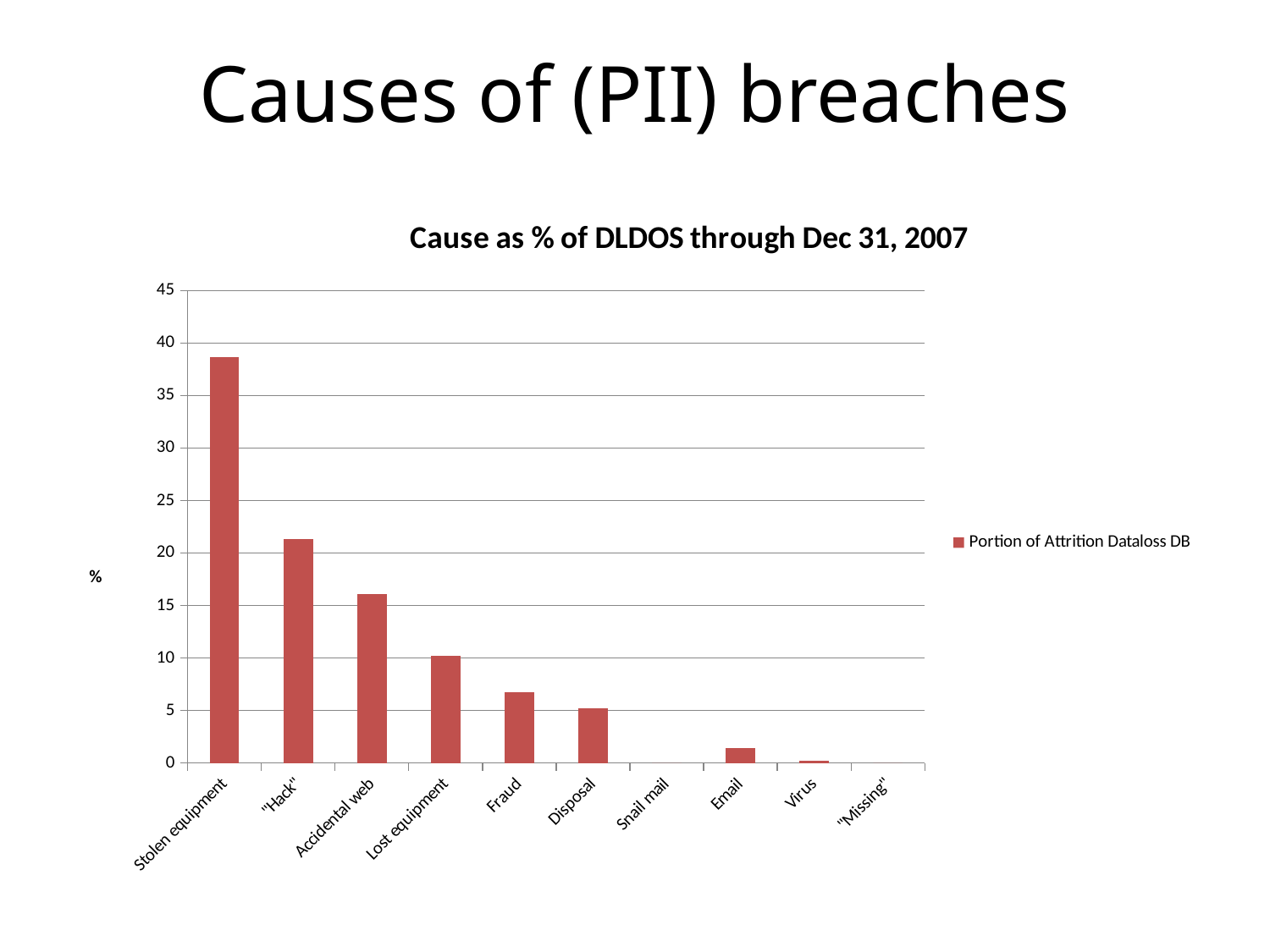
Do the values generally rise or fall moving from left to right along the x axis? fall Is the value for Accidental web greater or less than 20? less What is the title of the chart? Cause as % of DLDOS through Dec 31, 2007 Which is larger, the value for Lost equipment or the value for Disposal? Lost equipment Which cause has the highest value? Stolen equipment How many series does the legend list? 1 How many cause categories are shown on the x axis? 10 Is the value for Stolen equipment greater or less than 35? greater Is the value for "Hack" greater or less than 20? greater What is the name of the series shown in the legend? Portion of Attrition Dataloss DB What kind of chart is shown on the slide? bar chart